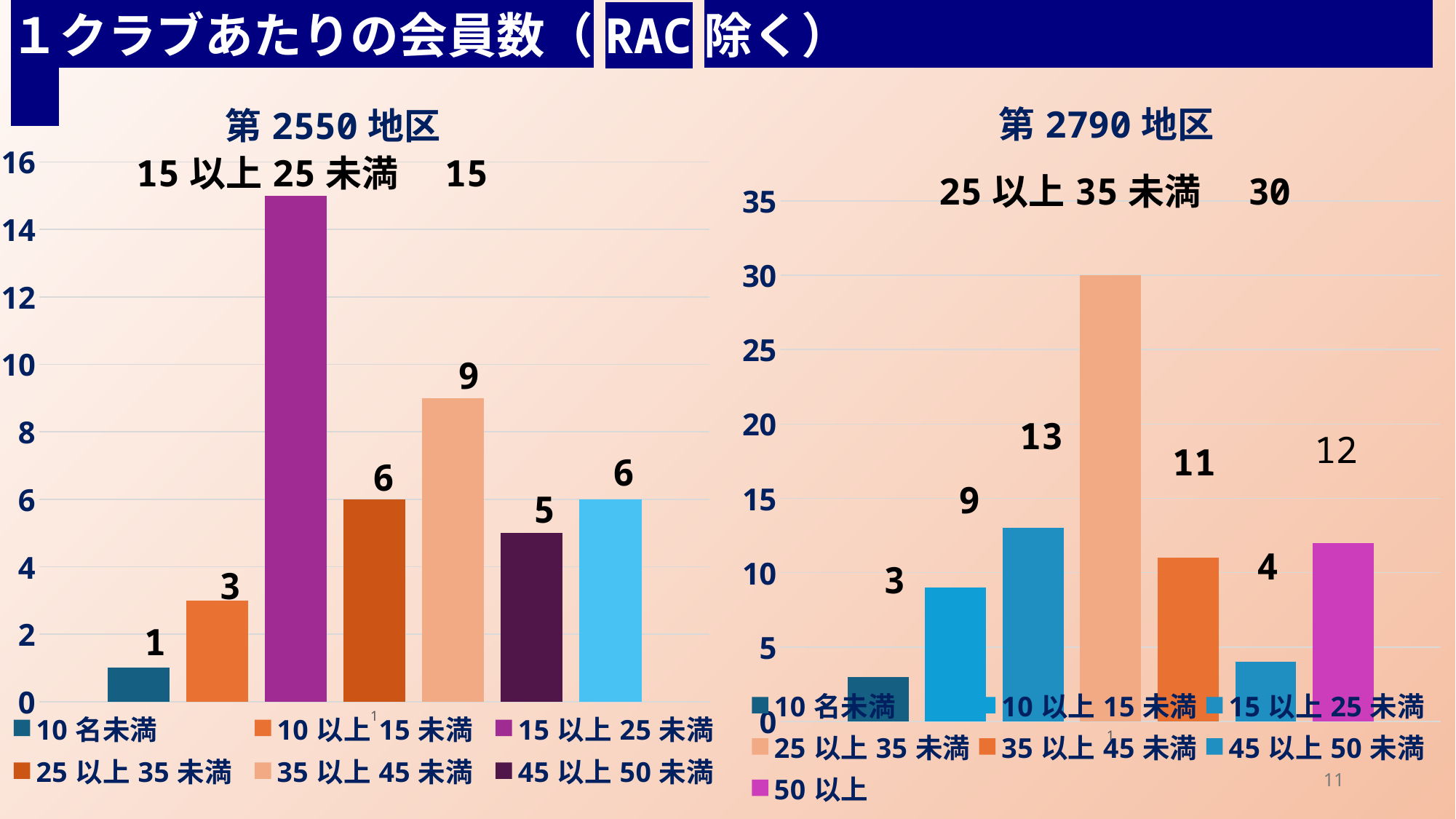
In the 第2550地区 chart, what is the value for 15以上25未満? 15 In the 第2790地区 chart, what is the difference between 25以上35未満 and 15以上25未満? 17 In the 第2790地区 chart, which category has the lowest value? 10名未満 In the 第2550地区 chart, what is the value for 35以上45未満? 9 In the 第2550地区 chart, what is the value for 10名未満? 1 In the 第2550地区 chart, which category has the highest value? 15以上25未満 In the 第2550地区 chart, what is the difference between 25以上35未満 and 10以上15未満? 3 In the 第2790地区 chart, what is the value for 50以上? 12 What kind of chart is the 第2550地区 chart? bar chart In the 第2790地区 chart, what is the value for 25以上35未満? 30 In the 第2790地区 chart, which is larger, 15以上25未満 or 35以上45未満? 15以上25未満 How many entries does the legend of the 第2790地区 chart list? 7